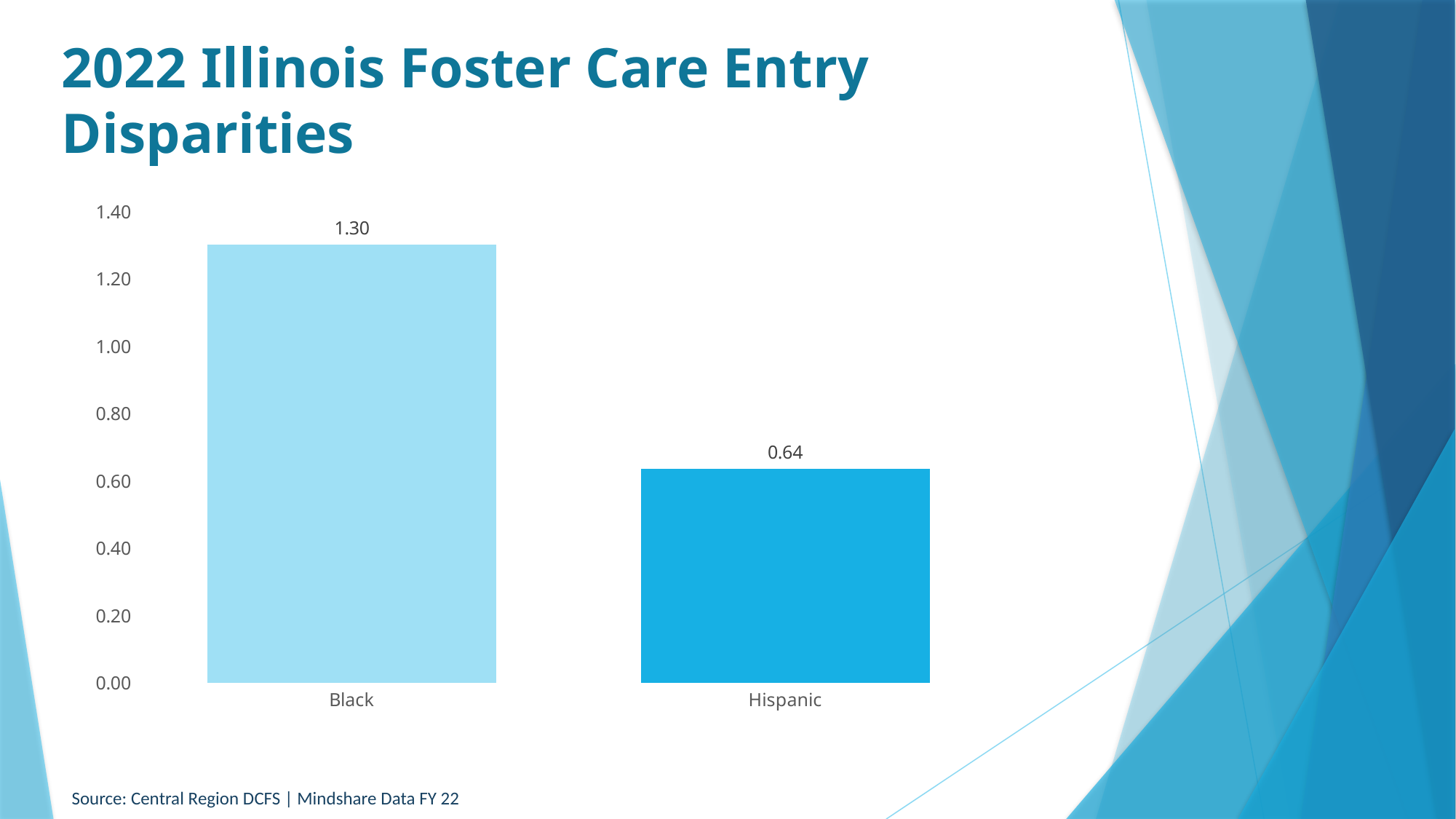
What is the value for Hispanic? 0.64 What is the highest value shown on the vertical axis? 1.40 Is the value for Black greater or less than 1.00? greater Is the value for Hispanic greater or less than 0.80? less What is the title of the slide? 2022 Illinois Foster Care Entry Disparities Which category has the lowest value? Hispanic What kind of chart is shown on the slide? bar chart Which category has the highest value? Black How many categories are shown in the chart? 2 What is the difference between the values for Black and Hispanic? 0.66 What is the value for Black? 1.30 Which is larger, the value for Black or the value for Hispanic? Black